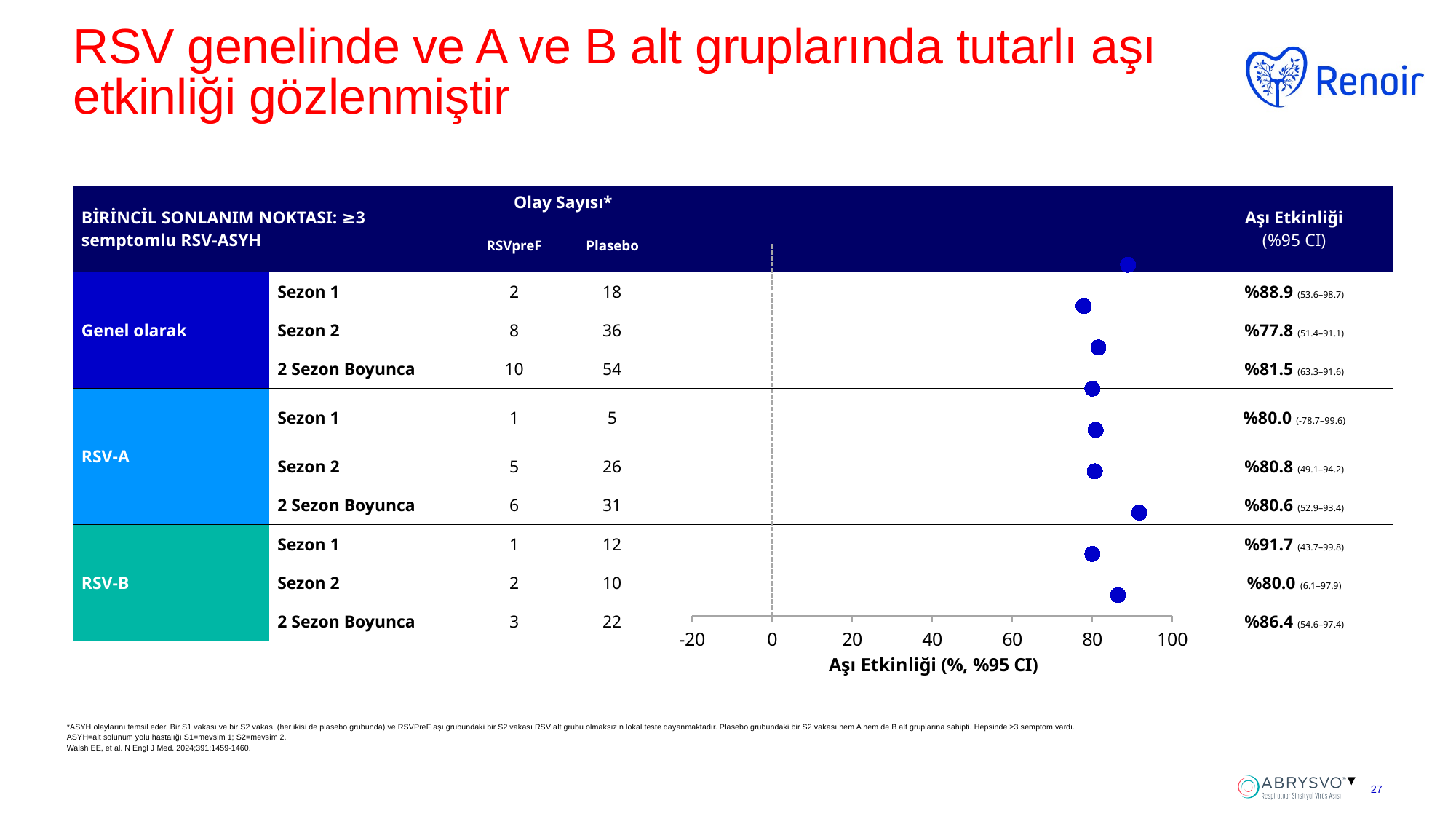
How many vaccine efficacy points are plotted on the chart? 9 What is the vaccine efficacy shown for RSV-A, Sezon 2? %80.8 What is the label of the x axis of the chart? Aşı Etkinliği (%, %95 CI) Which row has the lowest vaccine efficacy point estimate? Genel olarak, Sezon 2 (%77.8) What is the vaccine efficacy (Aşı Etkinliği) shown for Genel olarak, Sezon 1? %88.9 What is the difference in vaccine efficacy between Genel olarak Sezon 1 (%88.9) and Genel olarak Sezon 2 (%77.8)? 11.1 percentage points Which is larger: the vaccine efficacy for RSV-B Sezon 1 or for RSV-B 2 Sezon Boyunca? RSV-B Sezon 1 (%91.7) What are the minimum and maximum tick values shown on the x axis? -20 and 100 What kind of chart is used to display the vaccine efficacy estimates? Dot plot (forest plot) Which row has the highest vaccine efficacy point estimate? RSV-B, Sezon 1 (%91.7) What is the vaccine efficacy shown for RSV-B, 2 Sezon Boyunca? %86.4 Is the vaccine efficacy point for Genel olarak, Sezon 2 greater or less than 60 on the x axis? greater